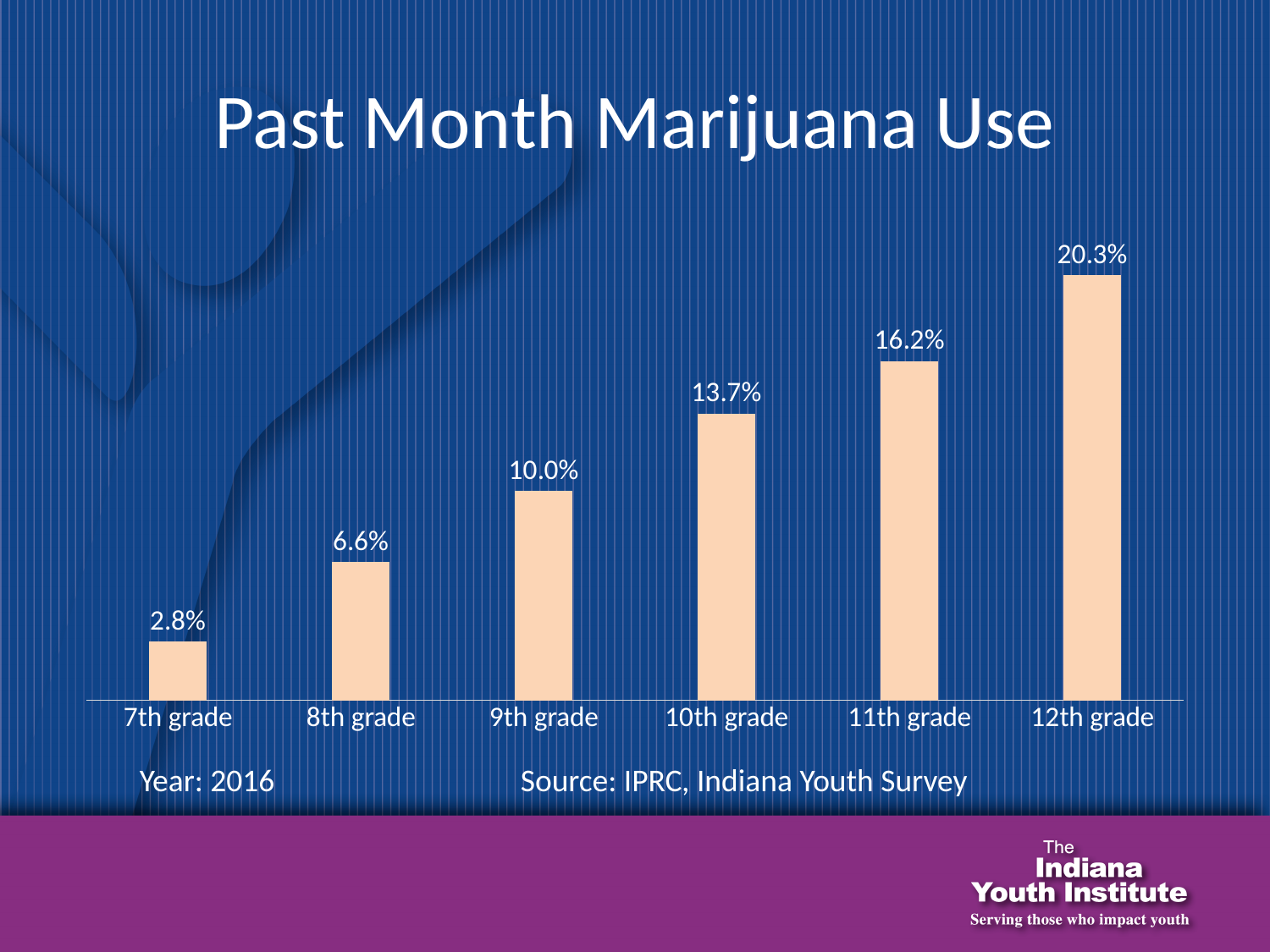
What is the past month marijuana use rate for 7th grade? 2.8% What is the past month marijuana use rate for 10th grade? 13.7% What kind of chart is shown on the slide? Bar chart What is the difference in past month marijuana use between 12th grade and 11th grade? 4.1% Which grade has the lowest past month marijuana use rate? 7th grade Do the past month marijuana use rates rise or fall from 7th grade to 12th grade? Rise Which grade has the highest past month marijuana use rate? 12th grade What is the difference in past month marijuana use between 9th grade and 8th grade? 3.4% How many grade levels are shown in the chart? 6 Which has a higher past month marijuana use rate, 9th grade or 11th grade? 11th grade What is the past month marijuana use rate for 12th grade? 20.3% What year does the chart's data come from? 2016